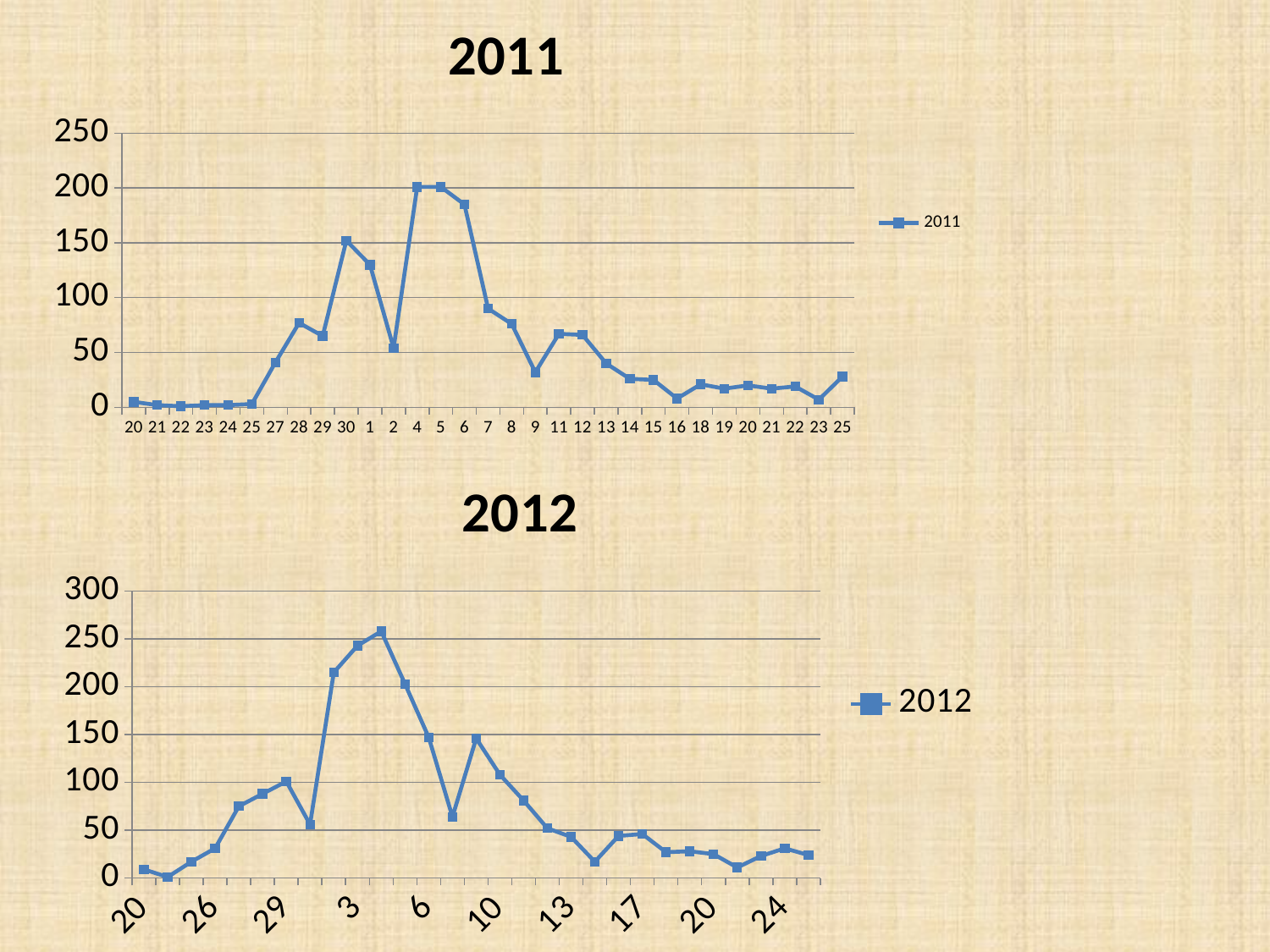
In the chart titled 2012, is the value at x label 26 greater or less than 50? less In the chart titled 2012, which is larger, the value at x label 3 or the value at x label 26? 3 What kind of chart is the chart titled 2011? line chart In the chart titled 2011, how many data points are plotted along the x axis? 31 In the chart titled 2011, is the value at x label 9 greater or less than 50? less What is the legend entry shown for the chart titled 2012? 2012 In the chart titled 2011, is the value at x label 6 greater or less than 150? greater In the chart titled 2011, do the values rise or fall from x label 6 to x label 9? fall In the chart titled 2011, which is larger, the value at x label 6 or the value at x label 9? 6 How many series does the legend of the chart titled 2012 list? 1